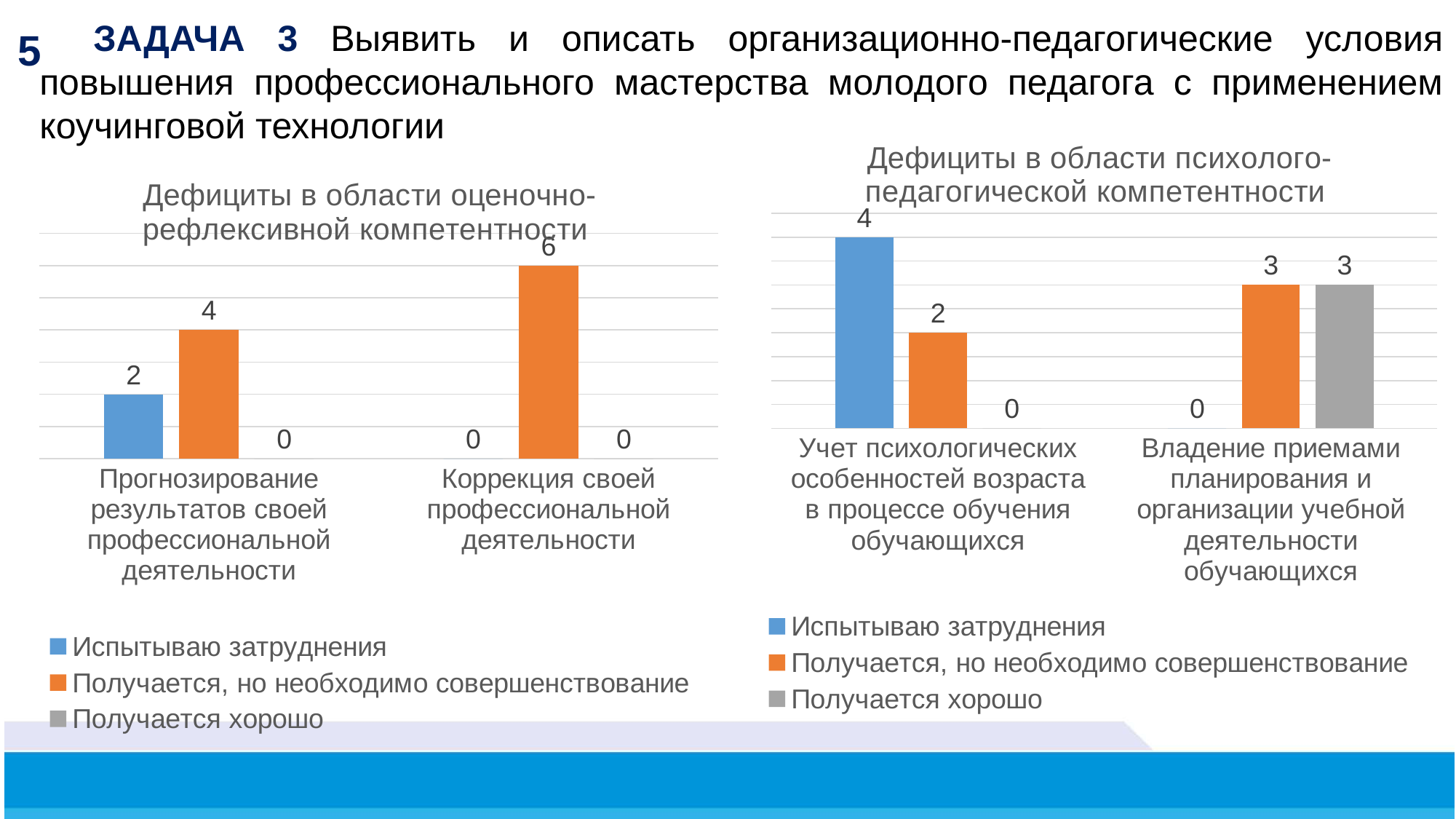
In the left chart (Дефициты в области оценочно-рефлексивной компетентности), which is larger: 'Испытываю затруднения' or 'Получается, но необходимо совершенствование' for 'Прогнозирование результатов своей профессиональной деятельности'? Получается, но необходимо совершенствование In the left chart (Дефициты в области оценочно-рефлексивной компетентности), what is the value for 'Получается, но необходимо совершенствование' in the category 'Коррекция своей профессиональной деятельности'? 6 What kind of chart is the right chart (Дефициты в области психолого-педагогической компетентности)? Bar chart In the right chart (Дефициты в области психолого-педагогической компетентности), which series has the highest value in the category 'Учет психологических особенностей возраста в процессе обучения обучающихся'? Испытываю затруднения How many series does the legend of the right chart (Дефициты в области психолого-педагогической компетентности) list? 3 In the left chart (Дефициты в области оценочно-рефлексивной компетентности), what is the value for 'Испытываю затруднения' in the category 'Прогнозирование результатов своей профессиональной деятельности'? 2 In the right chart (Дефициты в области психолого-педагогической компетентности), what is the value for 'Получается хорошо' in the category 'Владение приемами планирования и организации учебной деятельности обучающихся'? 3 How many categories are shown on the x axis of the left chart (Дефициты в области оценочно-рефлексивной компетентности)? 2 What colour represents the series 'Получается хорошо' in the legend of the left chart? Gray In the left chart (Дефициты в области оценочно-рефлексивной компетентности), what is the difference between the 'Получается, но необходимо совершенствование' values for the two categories? 2 In the right chart (Дефициты в области психолого-педагогической компетентности), what is the total of the three series values for 'Владение приемами планирования и организации учебной деятельности обучающихся'? 6 In the right chart (Дефициты в области психолого-педагогической компетентности), what is the value for 'Испытываю затруднения' in the category 'Учет психологических особенностей возраста в процессе обучения обучающихся'? 4